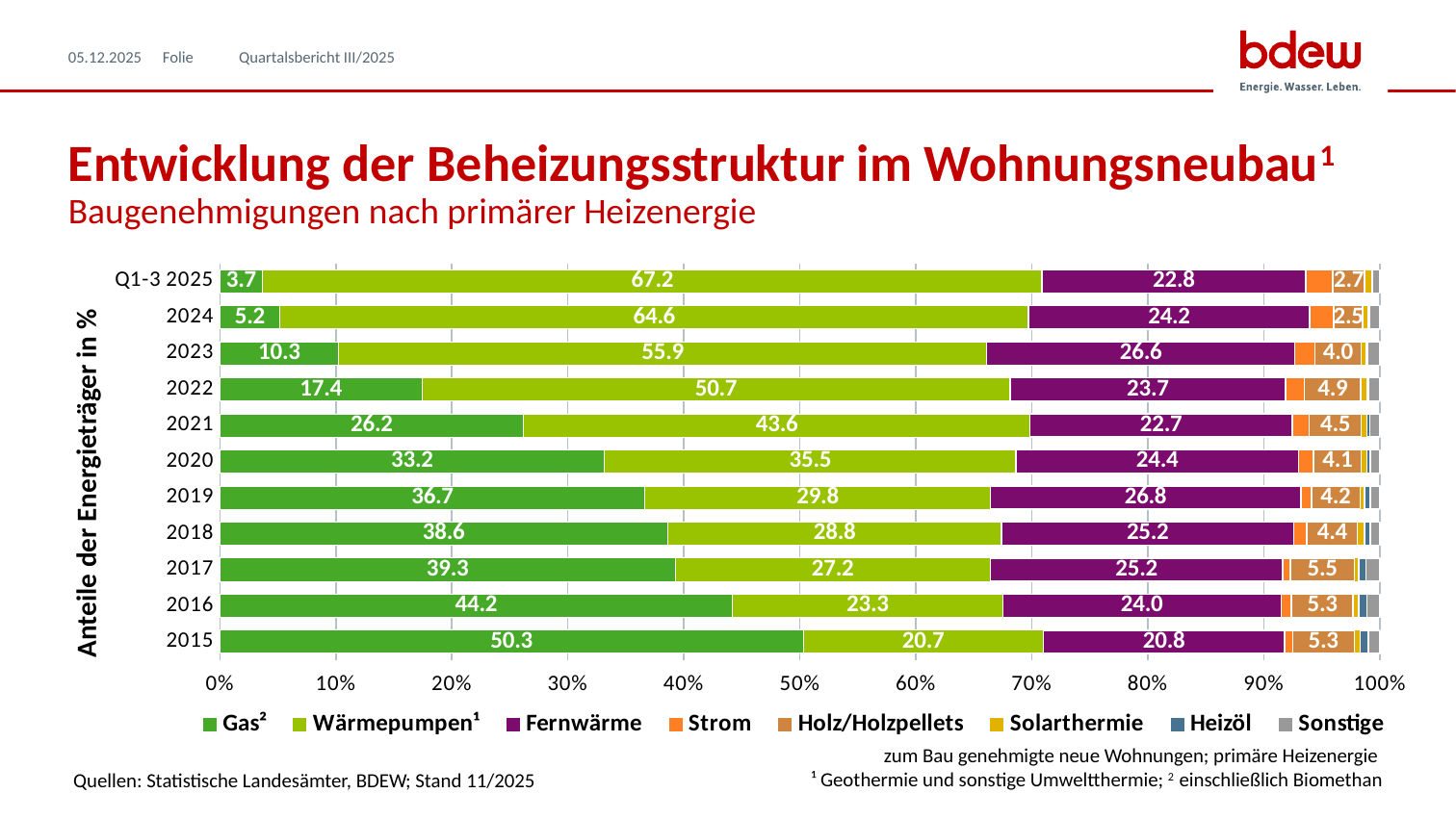
In which year shown is the share of Gas highest? 2015 What is the share of Holz/Holzpellets in 2022? 4.9 Which is larger in 2020: the share of Gas or the share of Wärmepumpen? Wärmepumpen What is the share of Fernwärme in 2019? 26.8 Does the share of Wärmepumpen rise or fall from 2015 to Q1-3 2025? Rise In which period shown is the share of Gas lowest? Q1-3 2025 What kind of chart is shown on the slide? Stacked bar chart What is the difference between the Wärmepumpen share in Q1-3 2025 and in 2015? 46.5 What is the share of Wärmepumpen in Q1-3 2025? 67.2 How many series does the legend list? 8 How many time periods are shown on the chart? 11 What is the share of Gas in 2015? 50.3